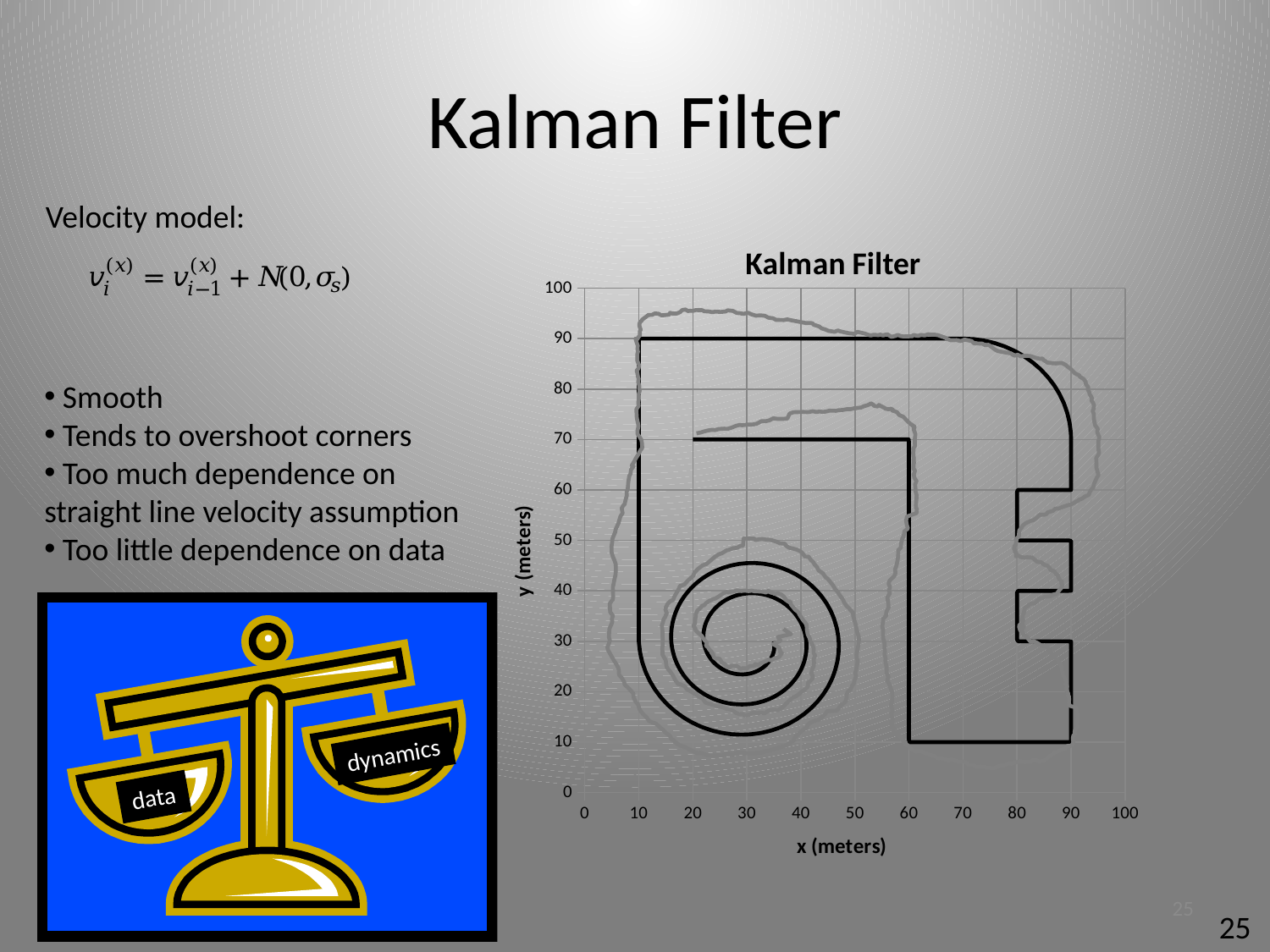
At what y value does the top horizontal segment of the black path lie? 90 How many plotted paths (lines) are shown on the chart? 2 Is the largest x value reached by the gray path greater or less than 90? greater At what y value does the bottom horizontal segment of the black path lie? 10 What is the label of the x axis of the chart? x (meters) What is the maximum value shown on the x axis of the chart? 100 What is the maximum value shown on the y axis of the chart? 100 Is the highest y value reached by the gray path greater or less than 90? greater At what x value does the left vertical segment of the black path lie? 10 What kind of chart is shown on the slide? line chart At what y value does the inner horizontal segment of the black path that starts at x = 20 lie? 70 What is the title of the chart? Kalman Filter